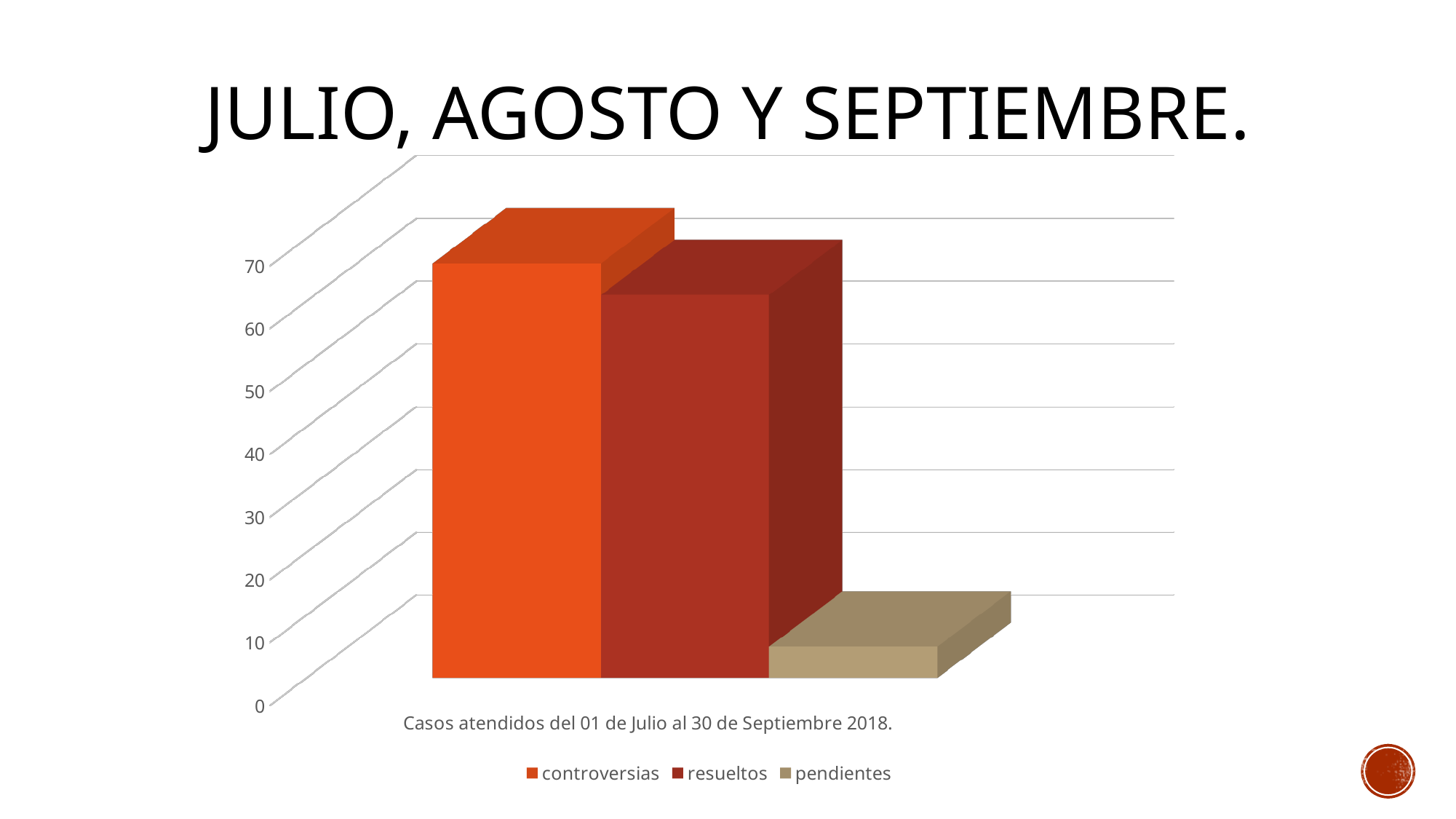
What is the category label shown below the bars? Casos atendidos del 01 de Julio al 30 de Septiembre 2018. Which series has the highest value? controversias What kind of chart is shown on the slide? bar chart Is the value for pendientes greater or less than 20? less Is the value for controversias greater or less than 60? greater How many series does the legend list? 3 Which series has the lowest value? pendientes Which is larger, the value for resueltos or the value for pendientes? resueltos What is the title of the slide? JULIO, AGOSTO Y SEPTIEMBRE. How many categories are shown on the x axis? 1 Which is larger, the value for controversias or the value for resueltos? controversias Is the value for resueltos greater or less than 70? less